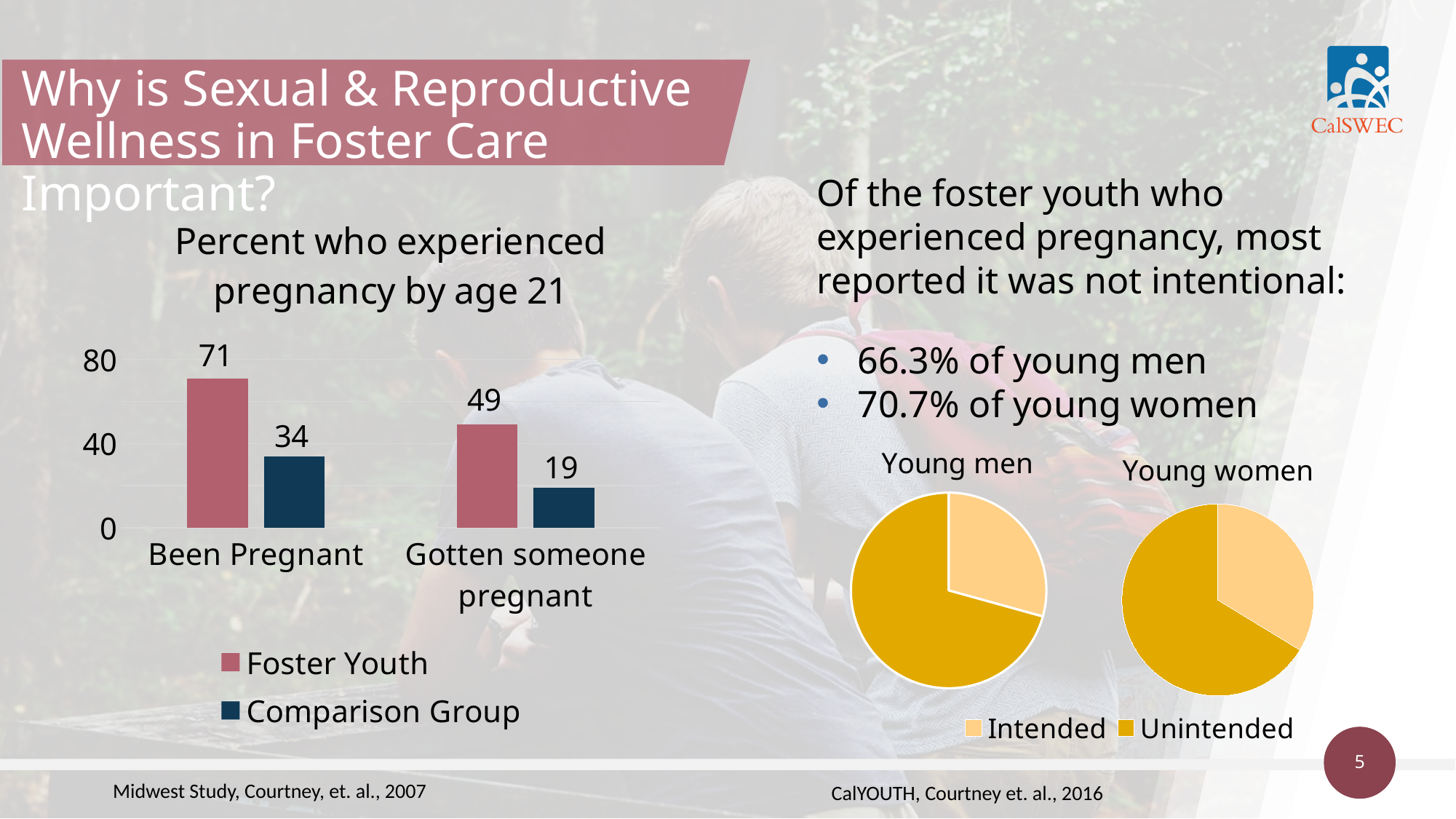
In the bar chart 'Percent who experienced pregnancy by age 21', which bar has the highest value? Foster Youth, Been Pregnant What kind of chart is 'Percent who experienced pregnancy by age 21'? Bar chart In the bar chart 'Percent who experienced pregnancy by age 21', what is the difference between the Foster Youth and Comparison Group values for 'Gotten someone pregnant'? 30 In the 'Young women' pie chart, which slice is larger, Intended or Unintended? Unintended In the 'Young men' pie chart, which colour represents the Unintended slice? Dark yellow In the bar chart 'Percent who experienced pregnancy by age 21', what is the value for the Comparison Group in the 'Gotten someone pregnant' category? 19 In the bar chart 'Percent who experienced pregnancy by age 21', what is the difference between the Foster Youth and Comparison Group values for 'Been Pregnant'? 37 In the bar chart 'Percent who experienced pregnancy by age 21', which bar has the lowest value? Comparison Group, Gotten someone pregnant In the bar chart 'Percent who experienced pregnancy by age 21', what is the value for Foster Youth in the 'Gotten someone pregnant' category? 49 In the bar chart 'Percent who experienced pregnancy by age 21', what is the value for the Comparison Group in the 'Been Pregnant' category? 34 In the bar chart 'Percent who experienced pregnancy by age 21', what is the value for Foster Youth in the 'Been Pregnant' category? 71 In the bar chart 'Percent who experienced pregnancy by age 21', how many series does the legend list? 2